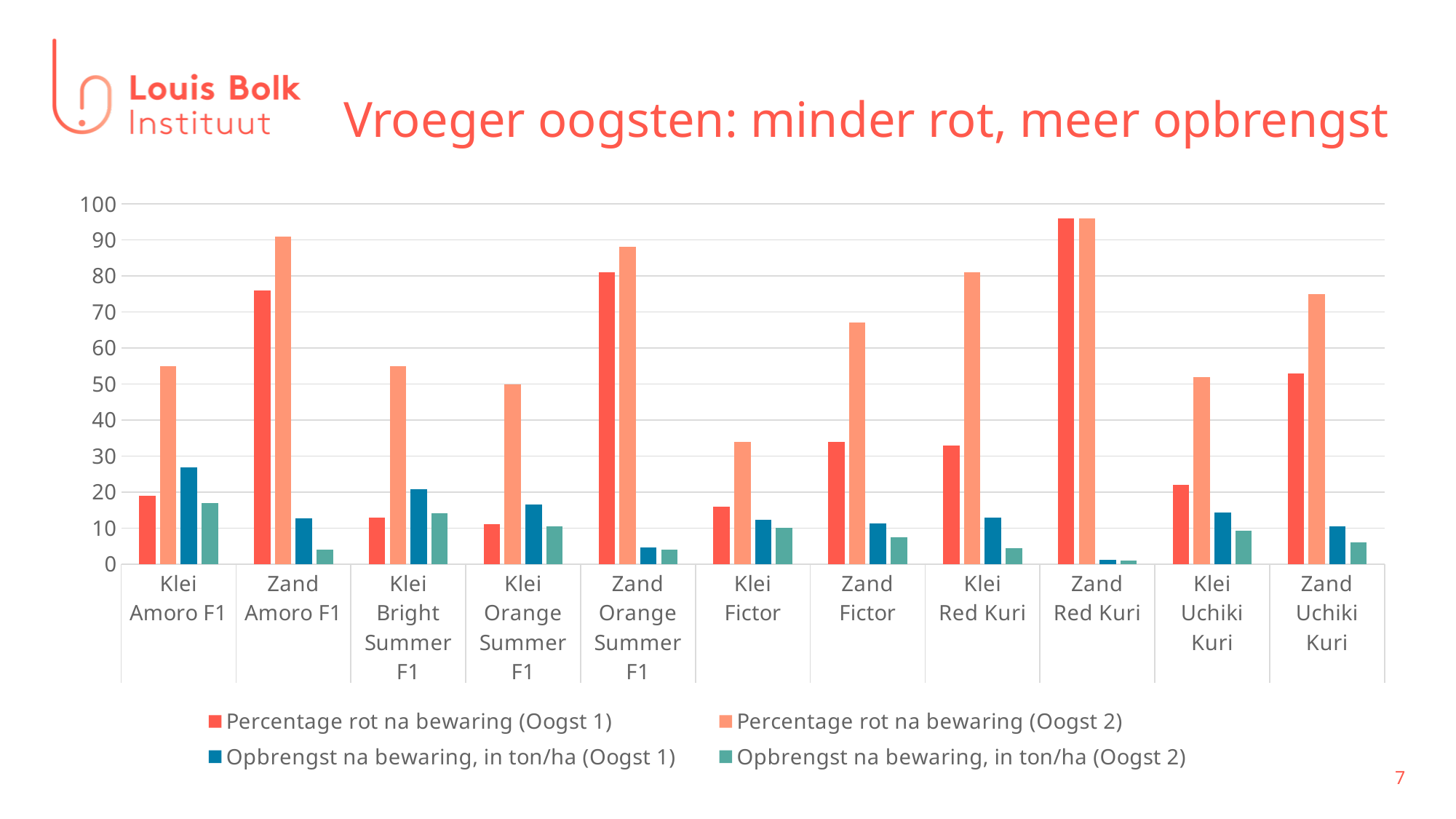
Is the value of 'Percentage rot na bewaring (Oogst 1)' for Klei Amoro F1 greater or less than 30? less What is the title of the slide above the chart? Vroeger oogsten: minder rot, meer opbrengst Is the value of 'Percentage rot na bewaring (Oogst 2)' for Klei Fictor greater or less than 40? less Which category has the highest value for 'Percentage rot na bewaring (Oogst 2)'? Zand Red Kuri How many categories are shown on the x axis of the chart? 11 For 'Percentage rot na bewaring (Oogst 1)', which is larger: Zand Amoro F1 or Klei Amoro F1? Zand Amoro F1 What kind of chart is shown on the slide? bar chart Is the value of 'Percentage rot na bewaring (Oogst 2)' for Zand Fictor greater or less than 60? greater How many series does the legend list? 4 Which category has the lowest value for 'Opbrengst na bewaring, in ton/ha (Oogst 1)'? Zand Red Kuri Which category has the highest value for 'Opbrengst na bewaring, in ton/ha (Oogst 1)'? Klei Amoro F1